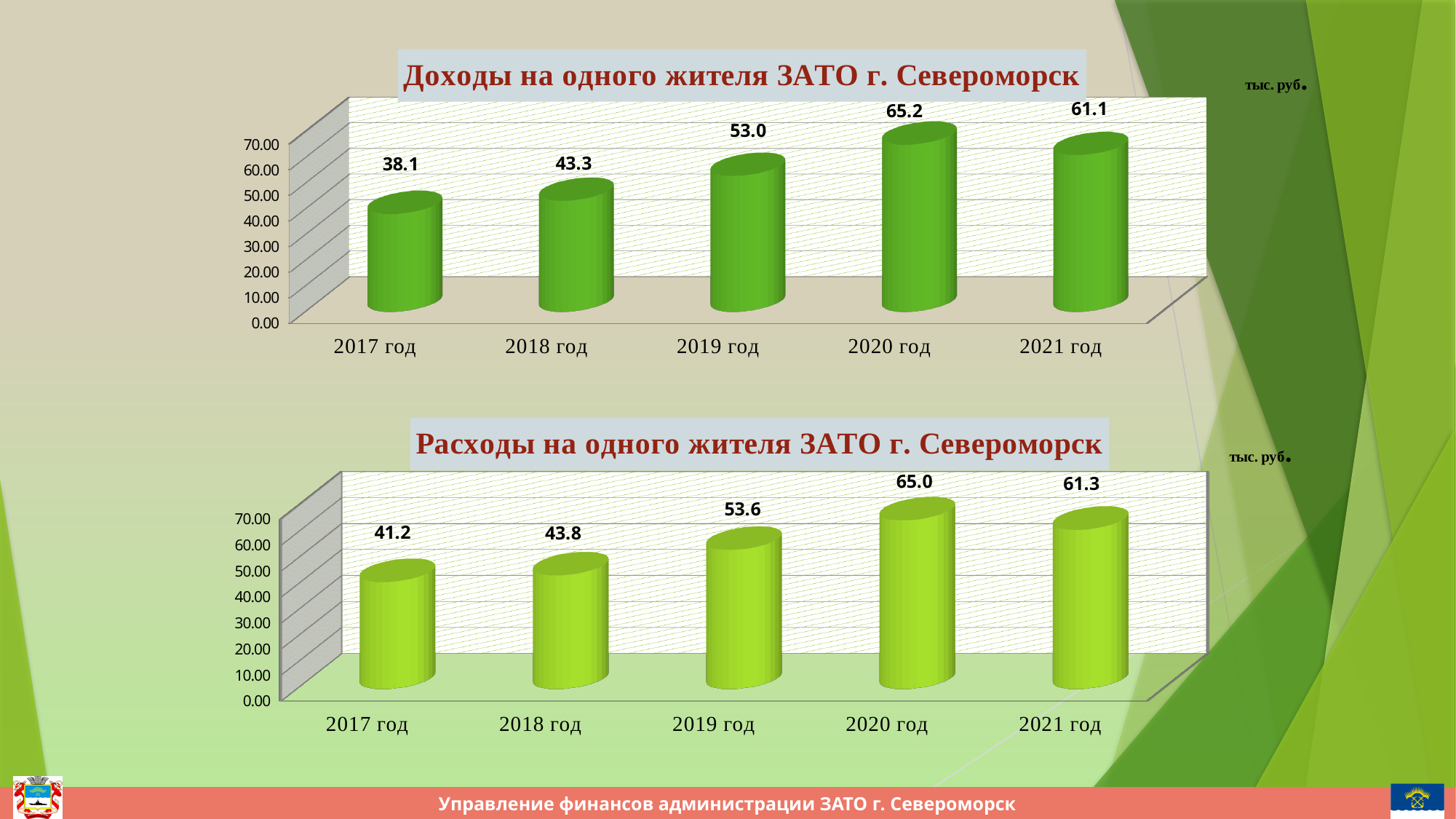
In the bottom chart (Расходы на одного жителя), which year has the lowest value? 2017 год In the top chart (Доходы на одного жителя), what is the difference between the values for 2020 год and 2017 год? 27.1 In the chart titled "Расходы на одного жителя ЗАТО г. Североморск", what is the value for 2017 год? 41.2 In the bottom chart (Расходы на одного жителя), is the value for 2019 год greater or less than 50.00? greater In the bottom chart (Расходы на одного жителя), what is the difference between the values for 2021 год and 2018 год? 17.5 In the top chart (Доходы на одного жителя), do the values rise or fall from 2017 год to 2020 год? rise In the top chart (Доходы на одного жителя), which year has the highest value? 2020 год In the chart titled "Доходы на одного жителя ЗАТО г. Североморск", what is the value for 2019 год? 53.0 What unit is indicated next to the top chart (Доходы на одного жителя)? тыс. руб. How many years are shown on the x axis of the top chart (Доходы на одного жителя)? 5 In the top chart (Доходы на одного жителя), which is larger: the value for 2020 год or the value for 2021 год? 2020 год What kind of chart is the bottom chart (Расходы на одного жителя)? bar chart